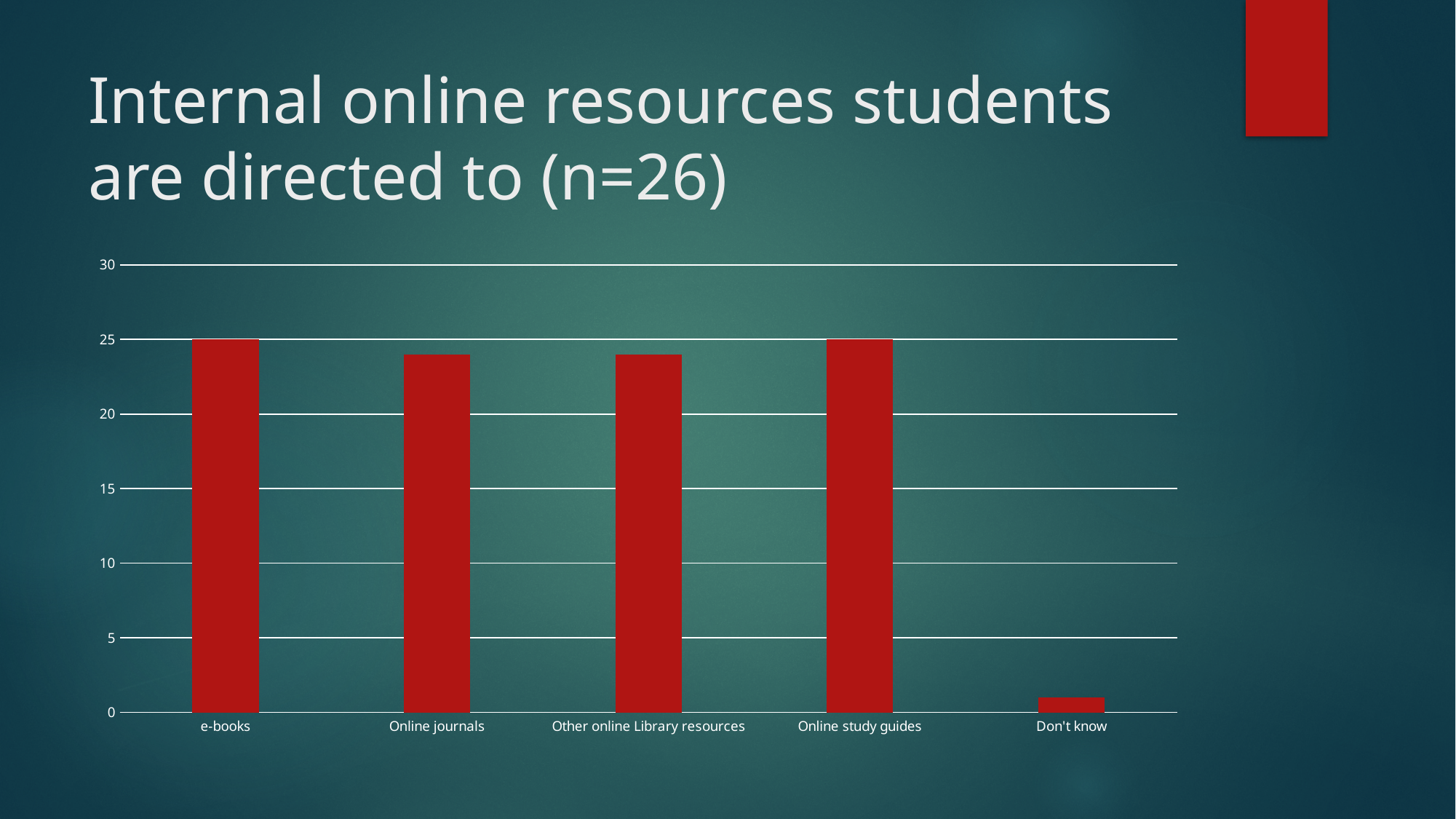
What is the value for Online study guides? 25 Is the value for Other online Library resources greater or less than 20? greater What is the title of the slide containing the chart? Internal online resources students are directed to (n=26) Is the value for Online journals greater or less than 25? less Is the value for Don't know greater or less than 5? less Which is larger, the value for e-books or the value for Don't know? e-books What is the value for e-books? 25 How many categories are shown on the x axis of the chart? 5 What kind of chart is shown on the slide? bar chart Which is larger, the value for Online journals or the value for Don't know? Online journals Which category has the lowest value in the chart? Don't know